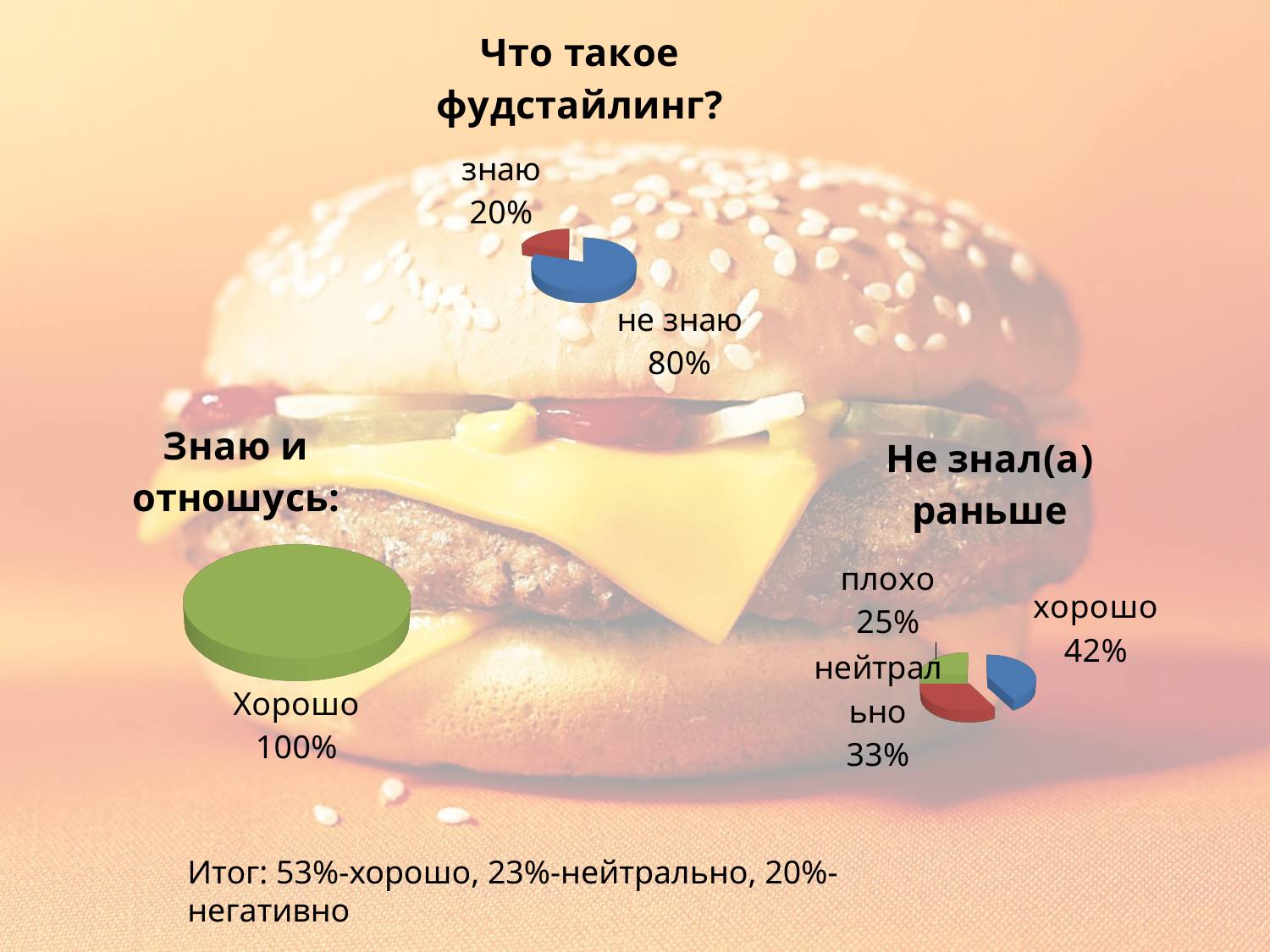
In the chart titled "Что такое фудстайлинг?", what percentage is labelled "знаю"? 20% In the chart titled "Что такое фудстайлинг?", which slice is larger, "знаю" or "не знаю"? не знаю In the chart titled "Не знал(а) раньше", what percentage is labelled "хорошо"? 42% In the chart titled "Не знал(а) раньше", which category has the smallest share? плохо In the chart titled "Знаю и отношусь:", what share is labelled "Хорошо"? 100% How many slices does the chart titled "Знаю и отношусь:" have? 1 In the chart titled "Что такое фудстайлинг?", what percentage is labelled "не знаю"? 80% In the chart titled "Что такое фудстайлинг?", what is the difference between the "не знаю" and "знаю" shares? 60% What kind of chart is used under the title "Знаю и отношусь:"? pie chart In the chart titled "Не знал(а) раньше", what percentage is labelled "нейтрально"? 33% How many slices does the chart titled "Не знал(а) раньше" have? 3 In the chart titled "Не знал(а) раньше", which category has the largest share? хорошо